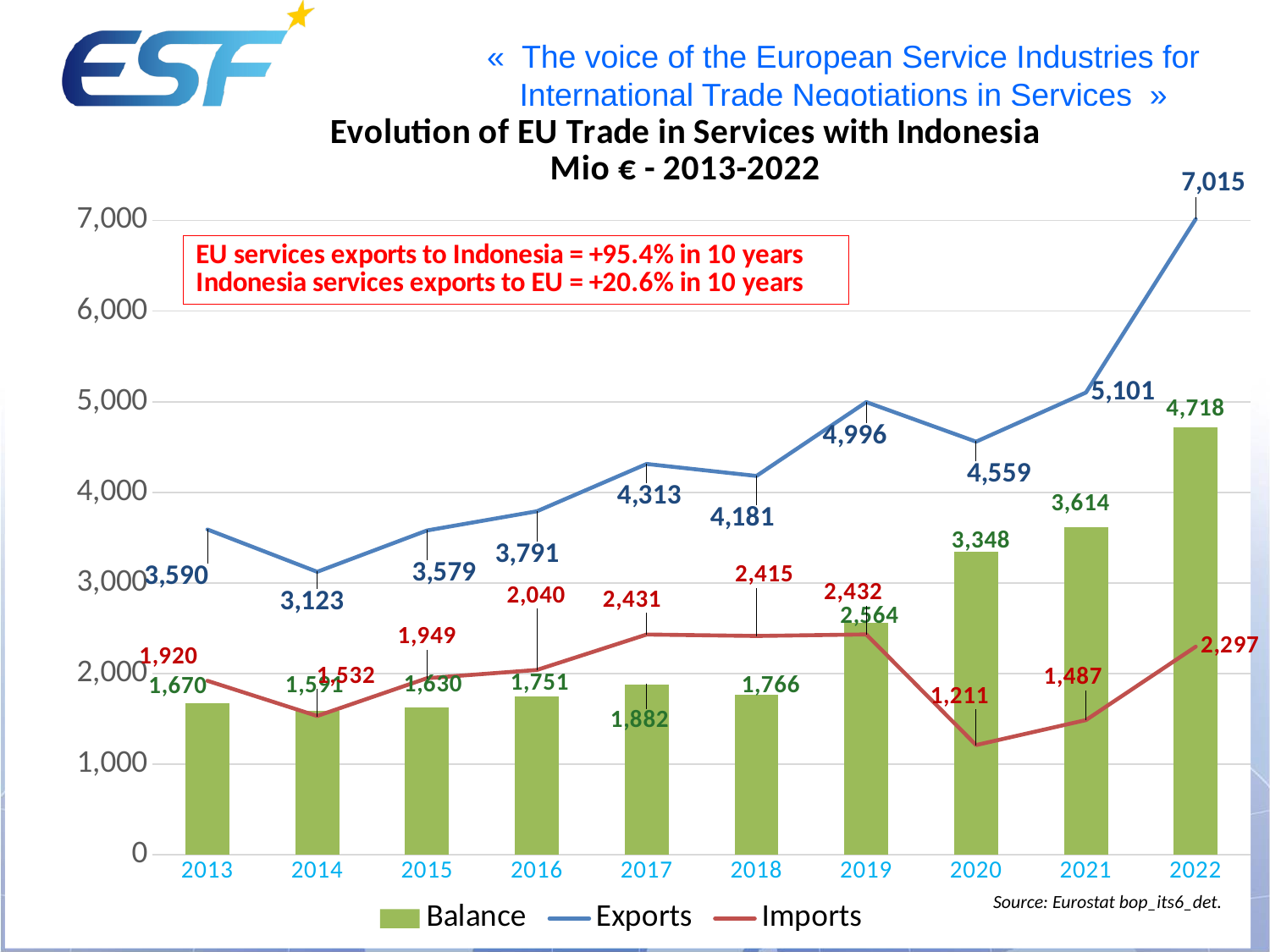
Is the Exports value for 2019 greater or less than 4,000? greater In which year is the Exports value lowest? 2014 What is the difference between Exports and Imports in 2021? 3,614 How many years are shown on the x axis? 10 How many series does the legend list? 3 What is the Exports value for 2022? 7,015 What is the source cited for the chart? Eurostat bop_its6_det. In which year is the Balance value highest? 2022 Which is larger, the Imports value in 2017 or the Imports value in 2022? 2017 What is the Imports value for 2020? 1,211 Does the Balance series rise or fall from 2019 to 2022? rise What is the Balance value for 2019? 2,564